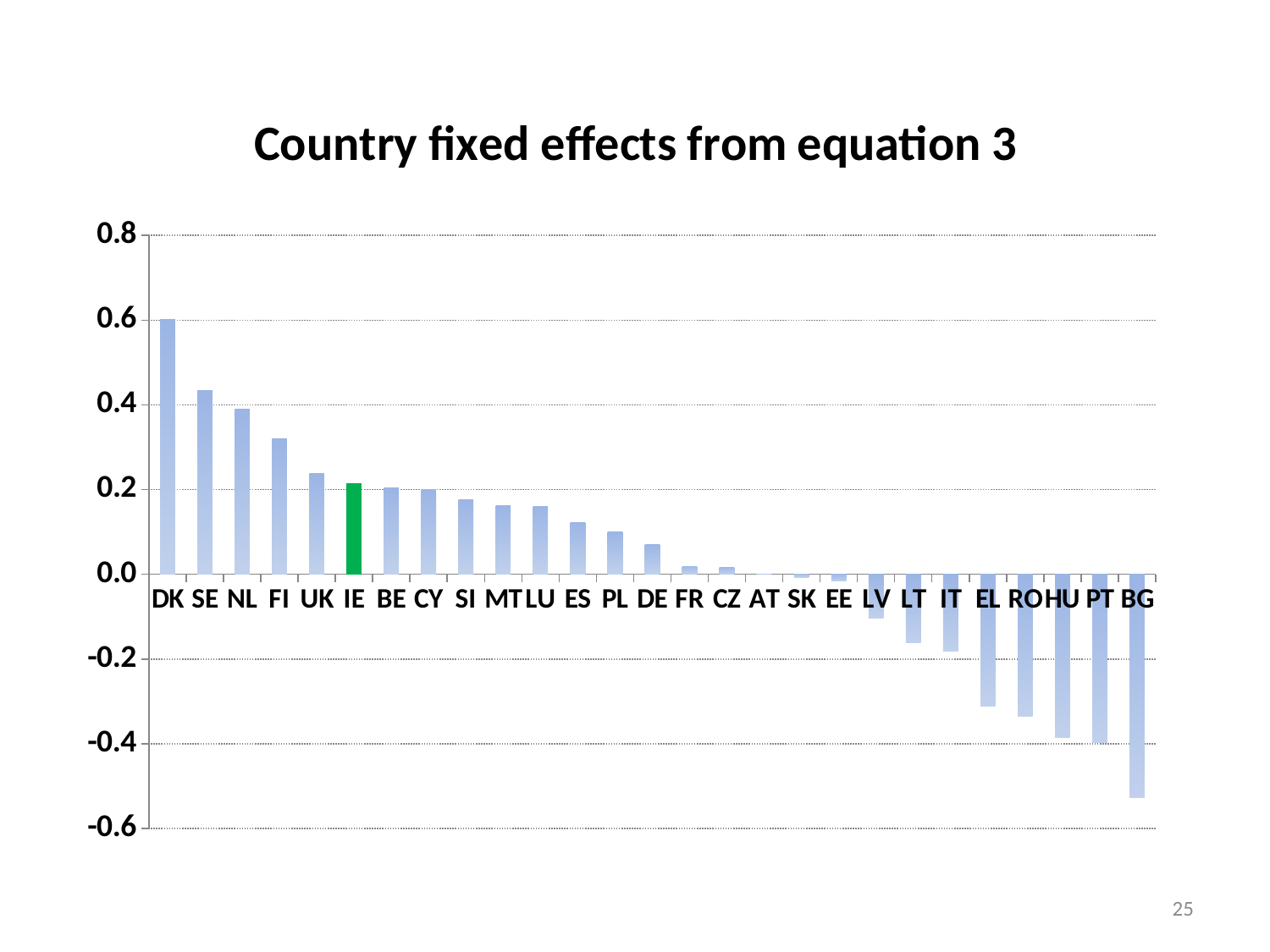
What kind of chart is shown on the slide? bar chart How many countries are shown on the x axis of the chart? 27 Which country's bar is highlighted in green? IE Which country has the highest fixed effect in the chart? DK Is the value for SE greater or less than 0.4? greater Is the value for BG greater or less than -0.4? less Which country has the lowest fixed effect in the chart? BG Which has the larger value, DK or SE? DK What is the title of the chart? Country fixed effects from equation 3 Do the values rise or fall moving from left to right along the x axis? fall